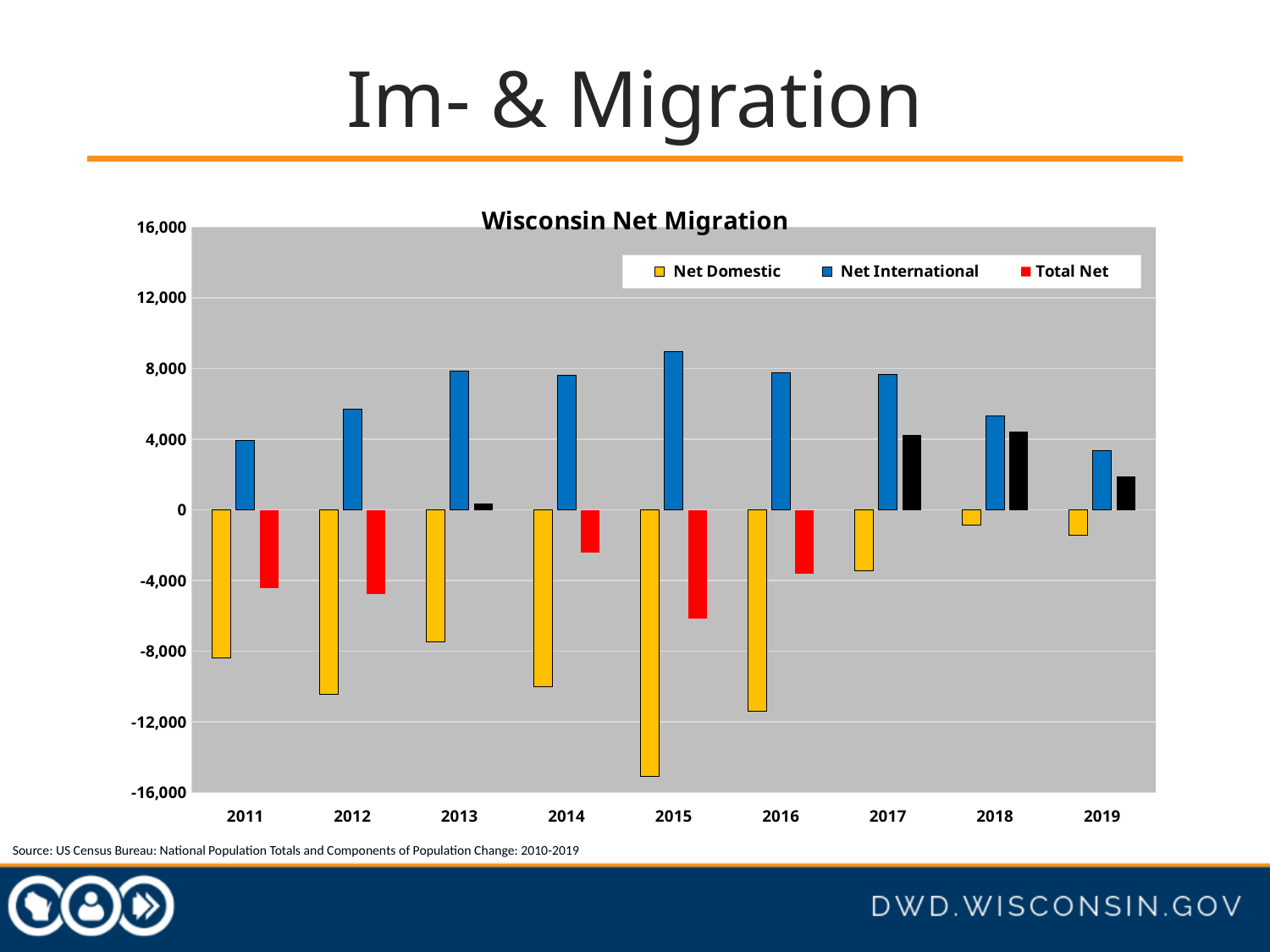
Is the Net International value for 2015 greater or less than 8,000? greater What is the title of the chart? Wisconsin Net Migration In which year is Total Net migration lowest? 2015 Which is larger, the Total Net value for 2017 or for 2011? 2017 What kind of chart is shown on the slide? Bar chart Is the Net Domestic value for 2015 greater or less than -12,000? less How many series does the legend of the Wisconsin Net Migration chart list? 3 In which year is Net Domestic migration lowest? 2015 How many years are shown on the x axis of the Wisconsin Net Migration chart? 9 Is the Net International value for 2012 greater or less than 4,000? greater In which year is Net International migration highest? 2015 Does Net International migration rise or fall from 2015 to 2019? Fall